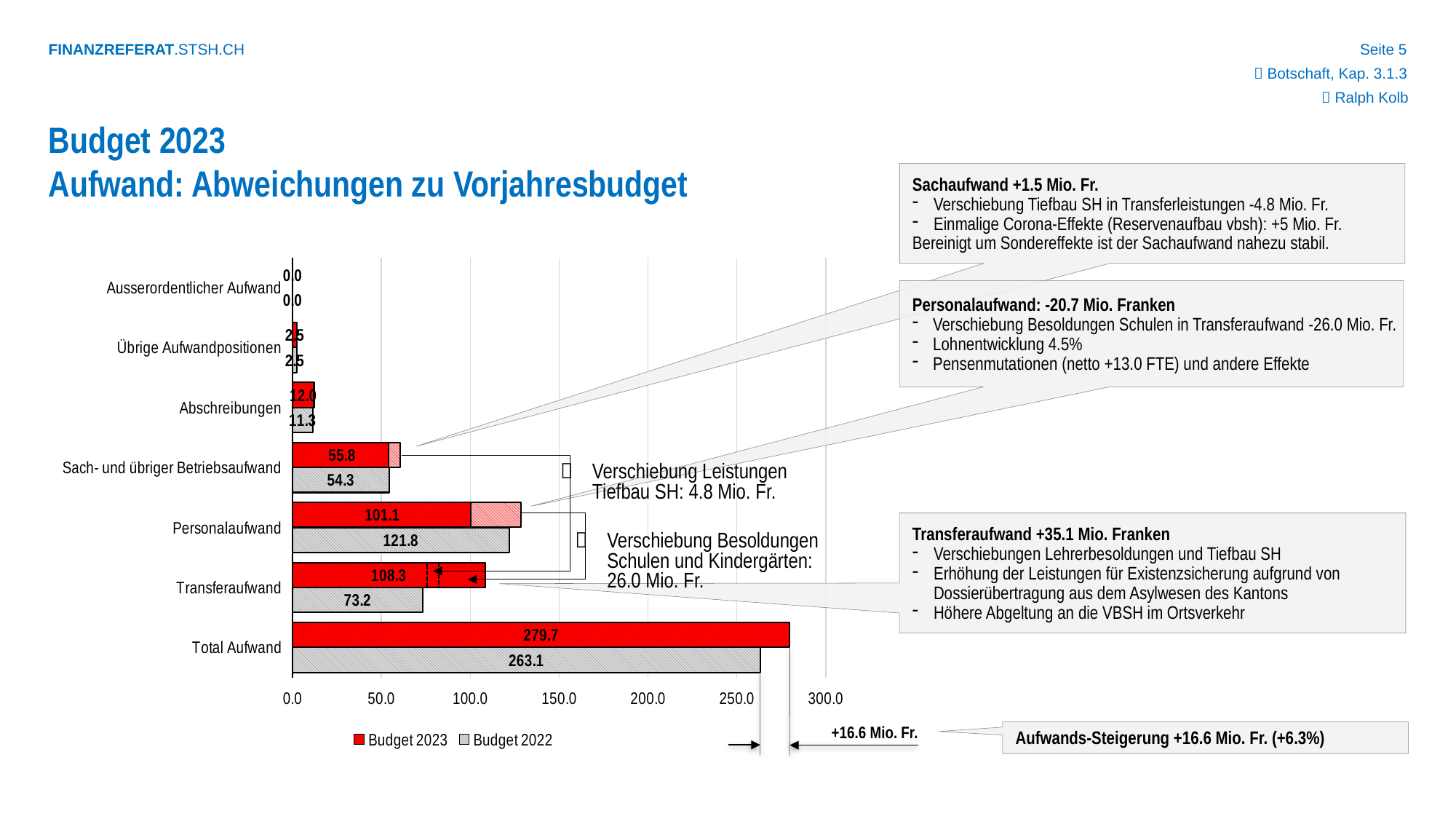
How many categories are shown on the chart? 7 What is the Budget 2022 value for Transferaufwand? 73.2 Which series is shown in red in the legend? Budget 2023 What type of chart is shown on the slide? bar chart Which category has the highest Budget 2023 value? Total Aufwand What is the Budget 2022 value for Sach- und übriger Betriebsaufwand? 54.3 For Personalaufwand, which is larger: the Budget 2023 value or the Budget 2022 value? Budget 2022 What is the difference between the Budget 2023 and Budget 2022 values for Transferaufwand? 35.1 Which category has the lowest Budget 2022 value? Ausserordentlicher Aufwand What is the Budget 2023 value for Personalaufwand? 101.1 What is the Budget 2023 value for Total Aufwand? 279.7 How many series does the legend list? 2